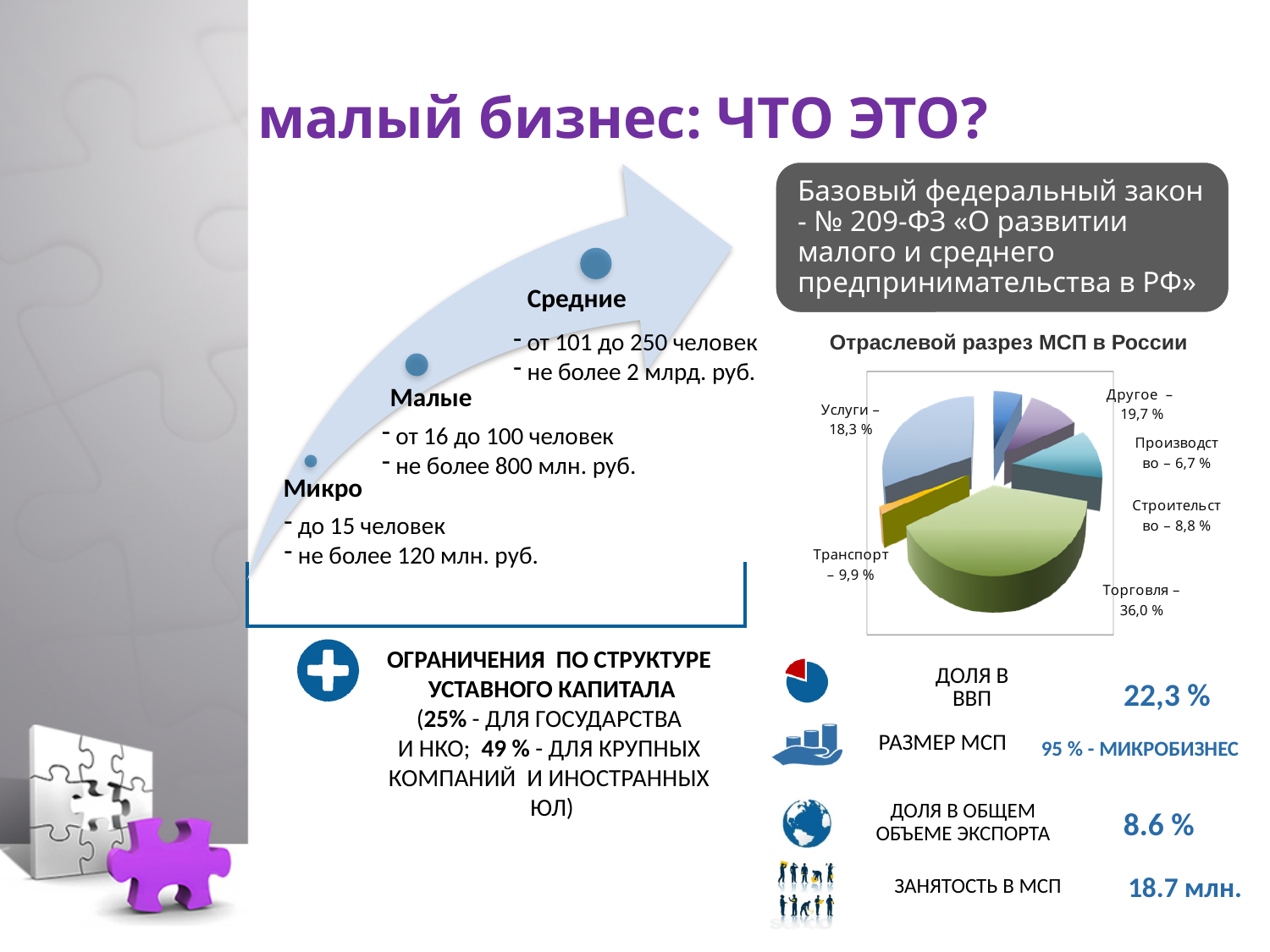
What share of the pie does Торговля have? 36,0 % Which sector has the smallest slice in the pie chart? Производство Which sector has the largest slice in the pie chart? Торговля What is the difference between the shares of Другое and Транспорт in the pie chart? 9,8 % What is the difference between the shares of Торговля and Услуги in the pie chart? 17,7 % What is the value shown for Услуги in the pie chart? 18,3 % What is the value shown for Другое in the pie chart? 19,7 % Which is larger in the pie chart, Строительство or Производство? Строительство What is the value shown for Транспорт in the pie chart? 9,9 % What is the title of the pie chart on the slide? Отраслевой разрез МСП в России What kind of chart is shown under the title "Отраслевой разрез МСП в России"? pie chart How many slices does the pie chart have? 6